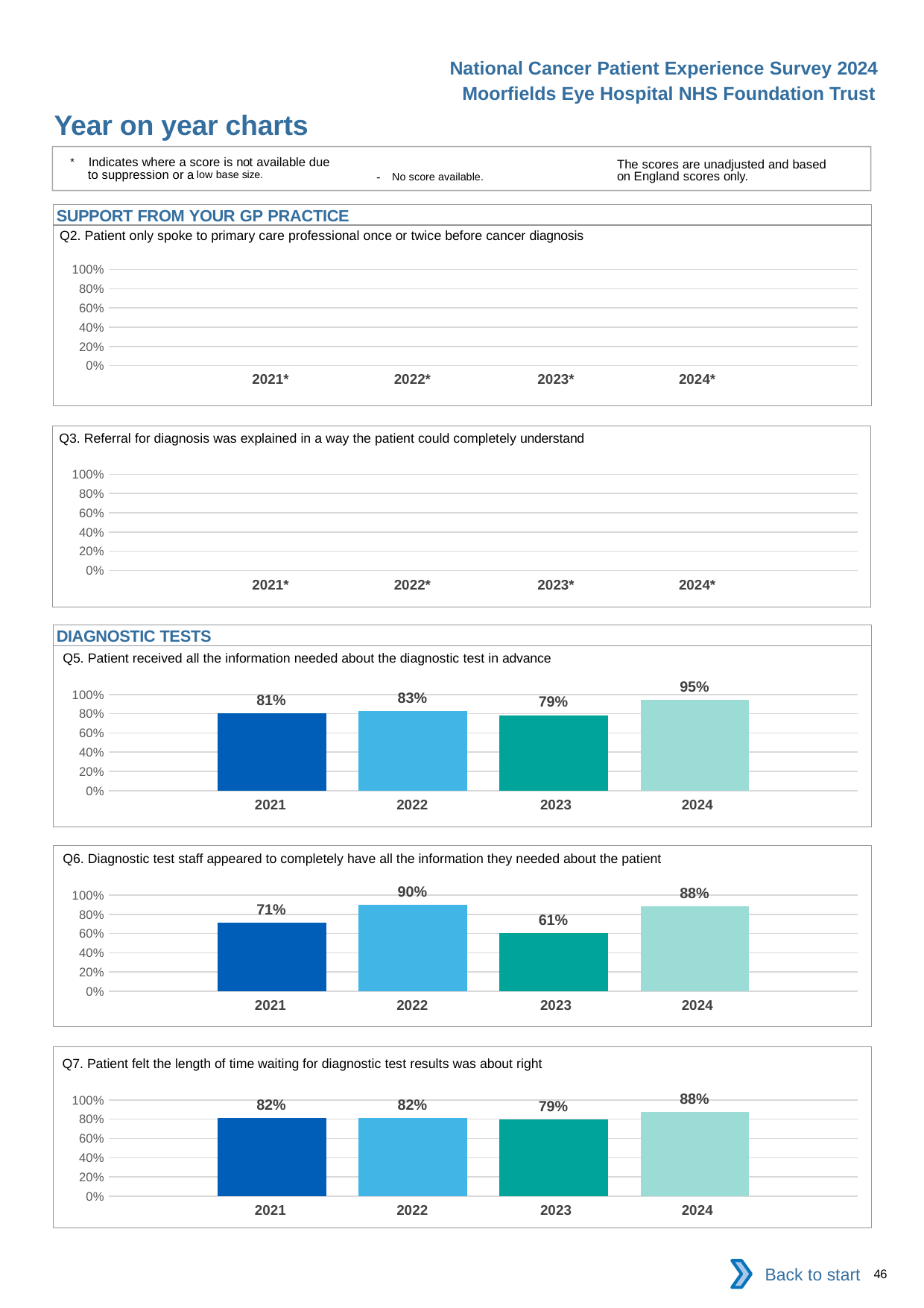
What kind of chart is the Q5 chart? Bar chart How many years are shown on the x axis of the Q7 chart? 4 In the Q2 chart (Patient only spoke to primary care professional once or twice before cancer diagnosis), how many bars are plotted? 0 In the Q6 chart, which is larger, the value for 2021 or the value for 2024? 2024 In the Q6 chart (Diagnostic test staff appeared to completely have all the information they needed about the patient), what is the value for 2023? 61% In the Q7 chart (Patient felt the length of time waiting for diagnostic test results was about right), what is the value for 2022? 82% In the Q6 chart, what is the difference between the 2022 and 2023 values? 29% In the Q5 chart (Patient received all the information needed about the diagnostic test in advance), what is the value for 2024? 95% In the Q5 chart, which year has the lowest value? 2023 In the Q5 chart, what is the difference between the 2024 and 2021 values? 14% In the Q6 chart, which year has the highest value? 2022 In the Q7 chart, which year has the highest value? 2024